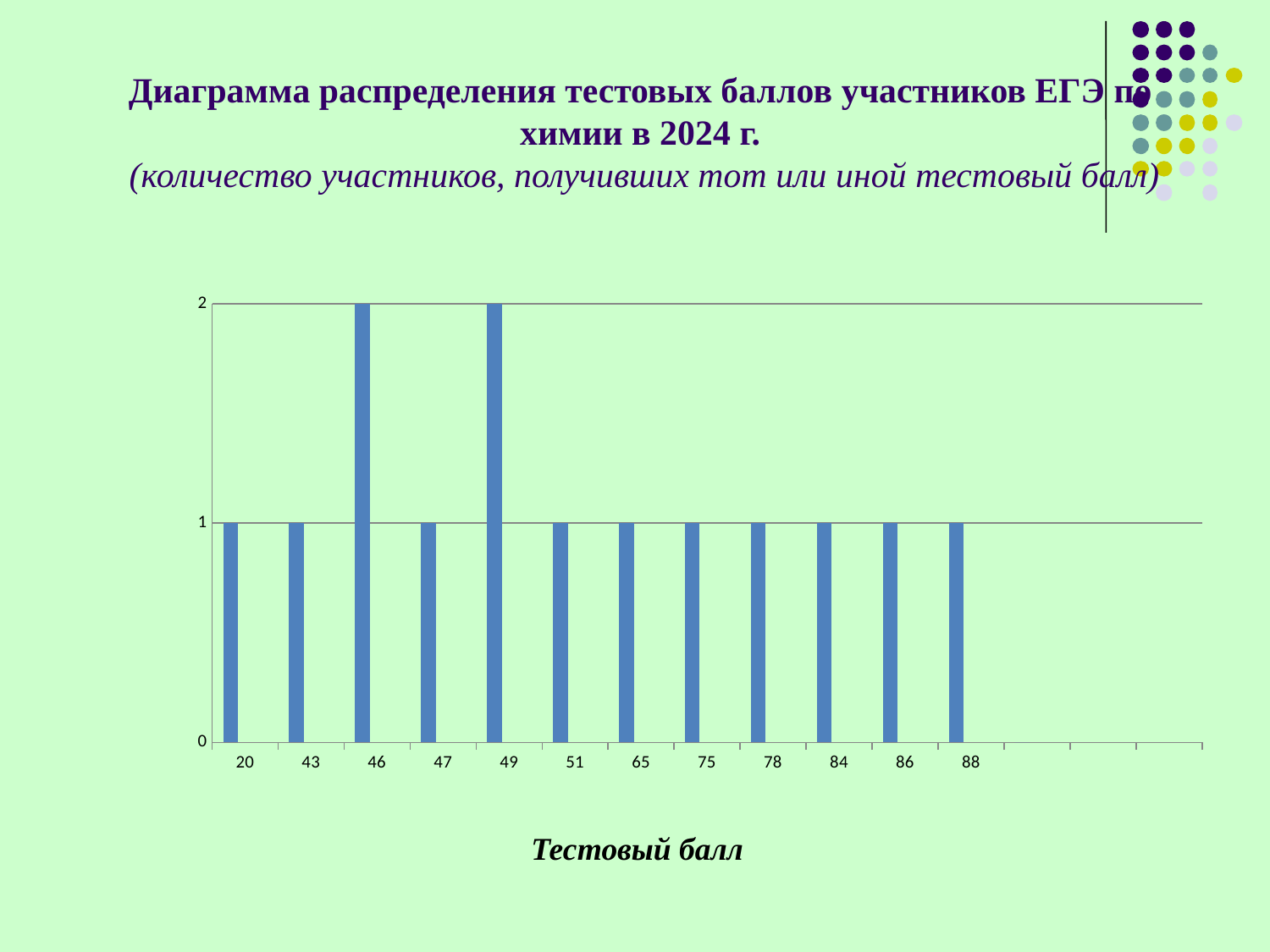
What is the label of the horizontal axis of the chart? Тестовый балл How many participants received a test score of 46? 2 How many participants received a test score of 49? 2 How many participants received a test score of 88? 1 What is the highest value shown on the vertical axis of the chart? 2 What kind of chart is shown on the slide? Bar chart What is the difference between the number of participants with a score of 46 and the number with a score of 20? 1 How many participants received a test score of 20? 1 Which test score has more participants, 46 or 84? 46 Which test scores have the highest number of participants? 46 and 49 How many test score categories are shown with bars on the chart? 12 Which test score has more participants, 49 or 75? 49